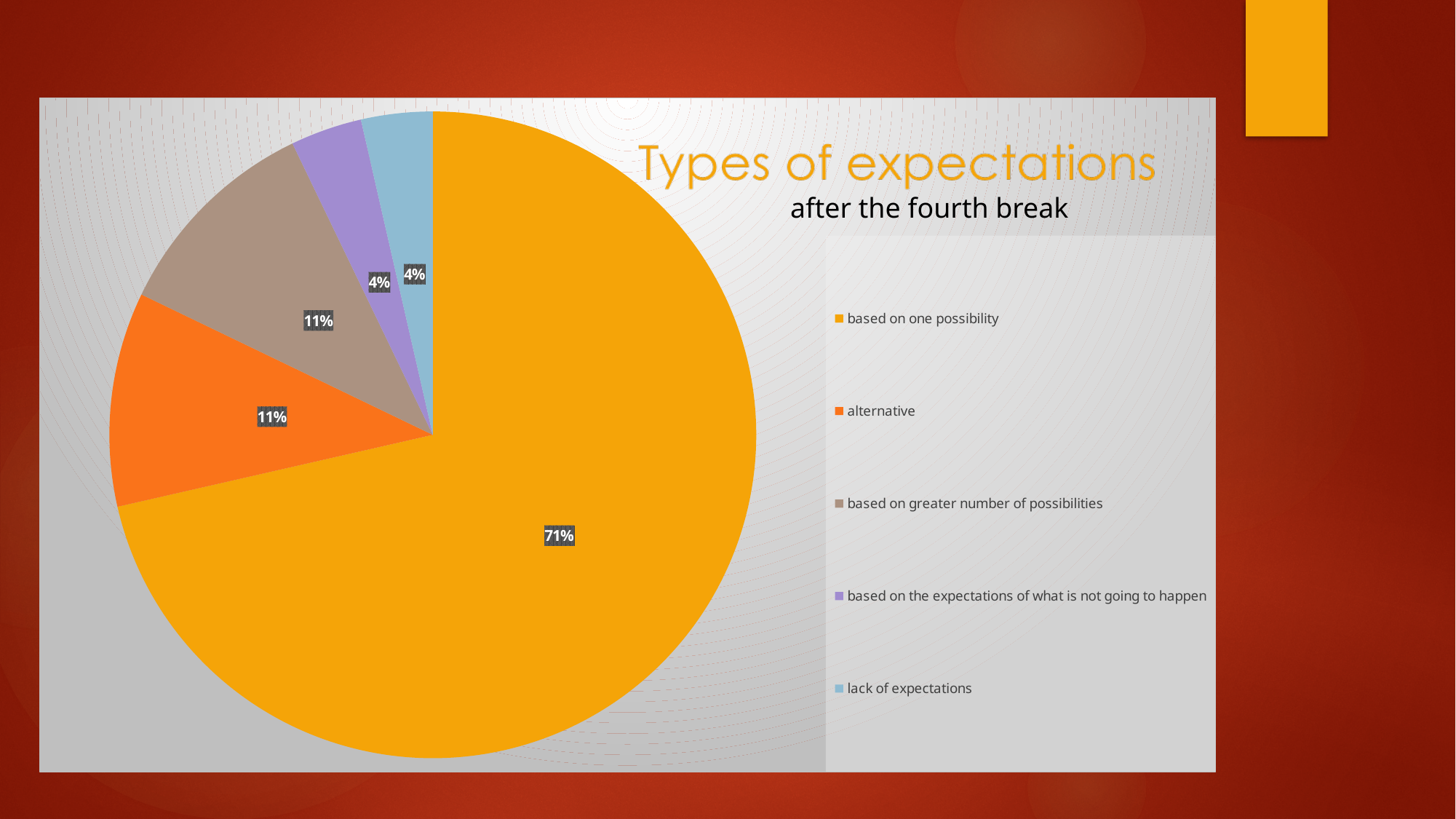
Which category has the largest slice of the pie? based on one possibility What share of the pie is 'based on greater number of possibilities'? 11% What share of the pie is 'lack of expectations'? 4% What share of the pie is 'based on one possibility'? 71% What colour is the slice for 'based on one possibility'? orange/yellow What is the title of the chart? Types of expectations after the fourth break How many categories does the pie chart show? 5 What is the difference in percentage points between 'based on one possibility' and 'alternative'? 60 Which is larger, the slice for 'alternative' or the slice for 'lack of expectations'? alternative What type of chart is shown on the slide? pie chart